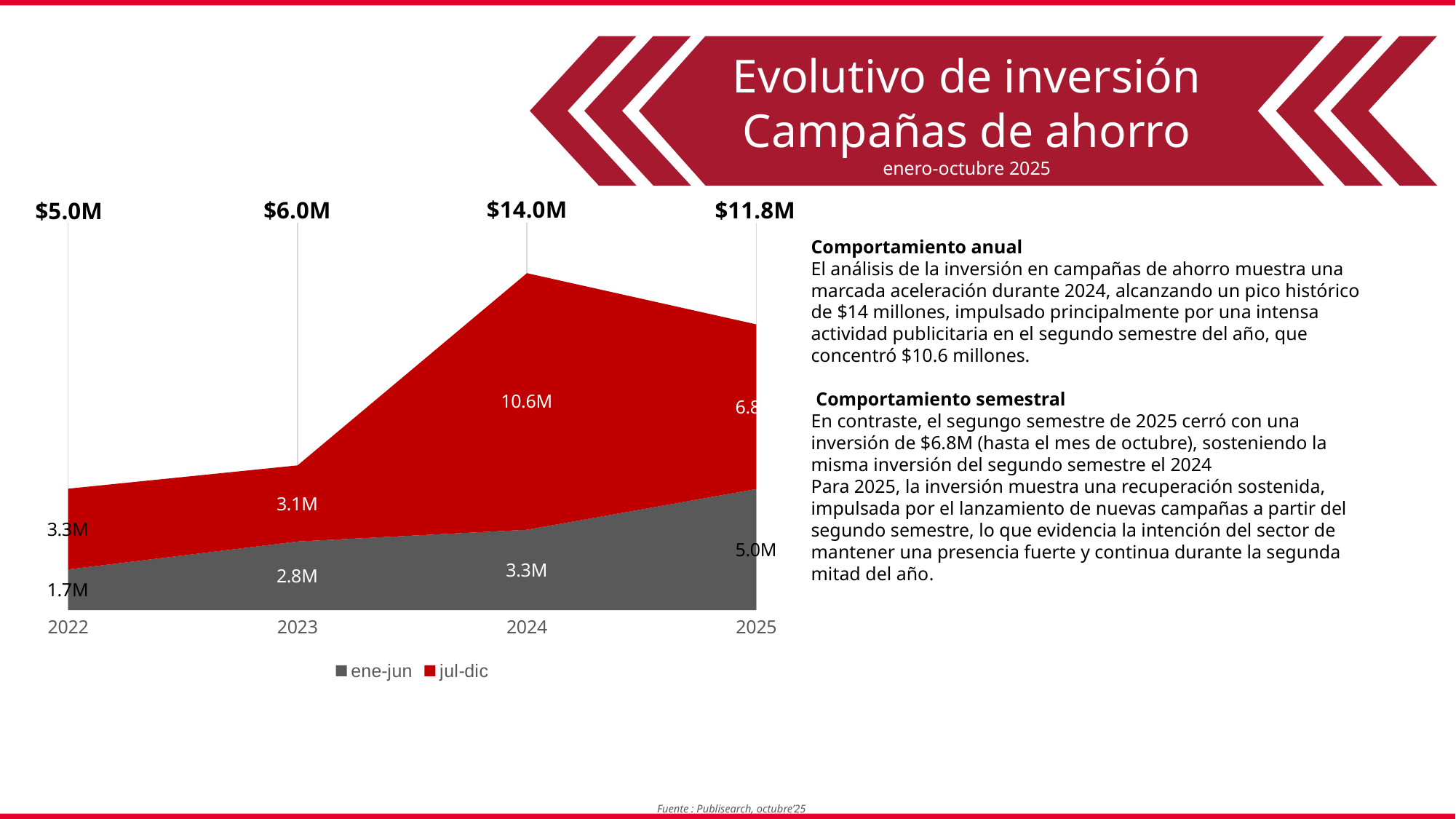
Which year has the highest total investment? 2024 What kind of chart is shown on the slide? Area chart How many years are shown on the x axis? 4 What is the ene-jun value for 2022? 1.7M How many series does the legend list? 2 Which is larger in 2023, the ene-jun value or the jul-dic value? jul-dic What is the jul-dic value for 2023? 3.1M Which year has the highest jul-dic value? 2024 What is the difference between the jul-dic value and the ene-jun value in 2024? 7.3M What is the ene-jun value for 2024? 3.3M Which year has the lowest total investment? 2022 What is the total investment shown above the chart for 2025? $11.8M